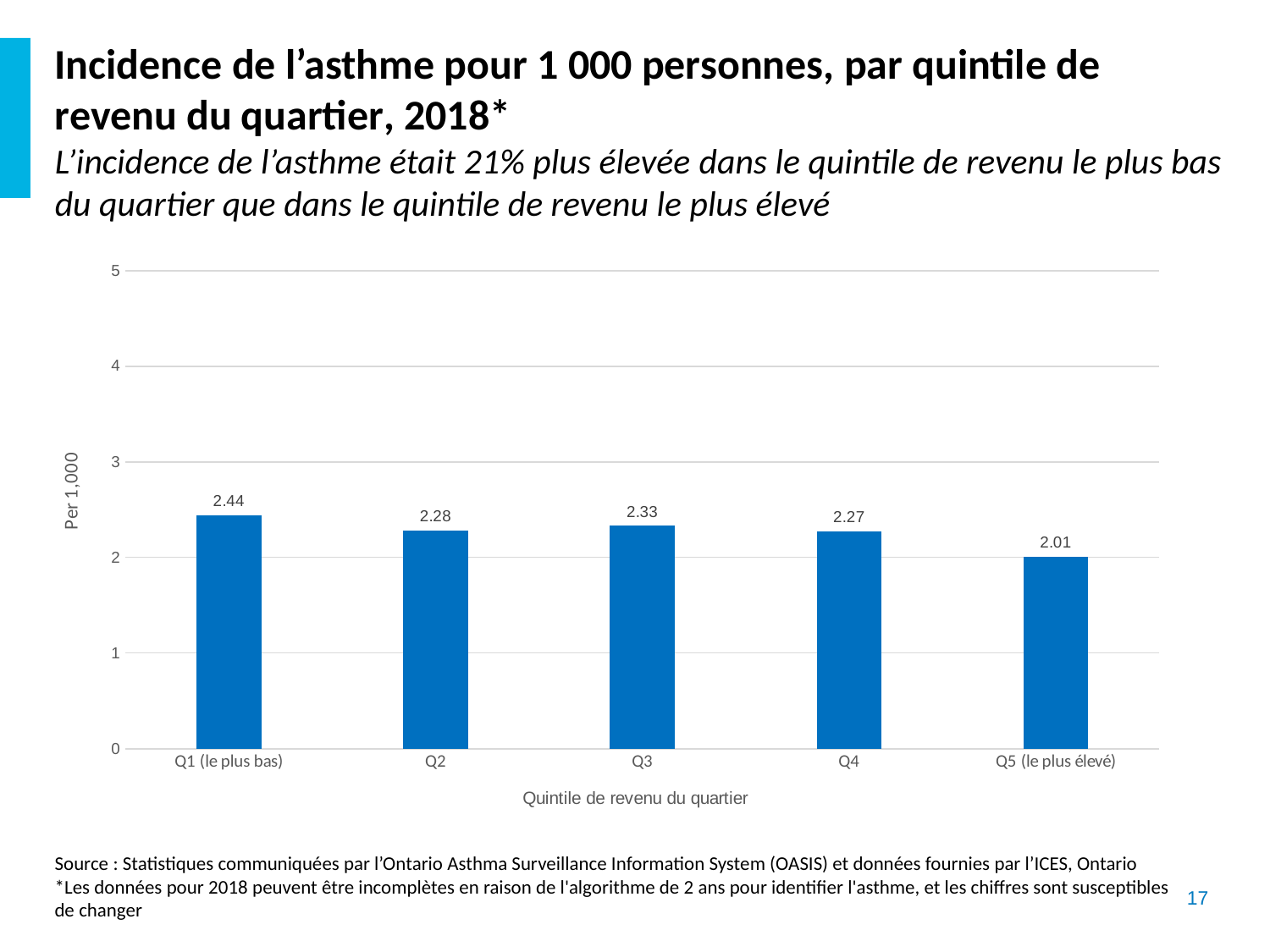
What kind of chart is shown on the slide? bar chart What is the difference between the values for Q2 and Q4? 0.01 What is the value shown for Q5 (le plus élevé)? 2.01 What is the asthma incidence per 1,000 for Q1 (le plus bas)? 2.44 What is the value shown for Q3? 2.33 How many quintile categories are shown on the x axis? 5 Which quintile has the lowest asthma incidence? Q5 (le plus élevé) Which is larger, the value for Q3 or the value for Q4? Q3 What is the label of the y axis? Per 1,000 What is the difference between the values for Q1 (le plus bas) and Q5 (le plus élevé)? 0.43 Which quintile has the highest asthma incidence? Q1 (le plus bas) Is the value for Q2 greater or less than 3? less